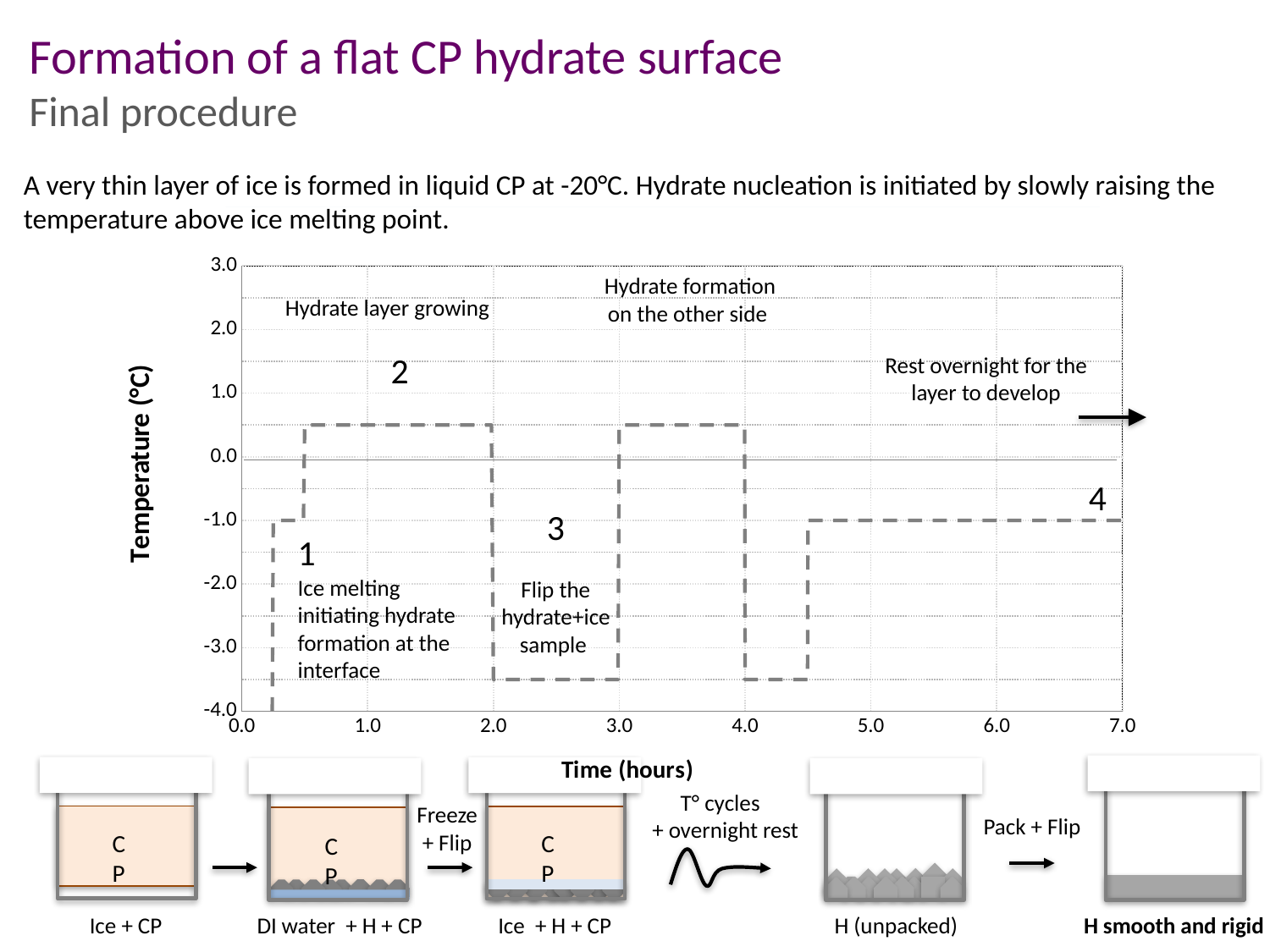
What is the label of the x axis of the chart? Time (hours) Is the temperature at 3.5 hours greater or less than 0.0 °C? greater Is the temperature during stage 2 (between 1.0 and 2.0 hours) greater or less than 0.0 °C? greater Which is higher, the temperature at 1.5 hours or the temperature at 6.0 hours? 1.5 hours What is the label of the y axis of the chart? Temperature (°C) Is the temperature at 4.2 hours greater or less than -3.0 °C? less What is the temperature plateau from 4.5 to 7.0 hours, as read from the y axis? -1.0 What kind of chart is shown on the slide? line chart How many numbered stages are marked on the chart? 4 What is the highest value shown on the x axis of the chart? 7.0